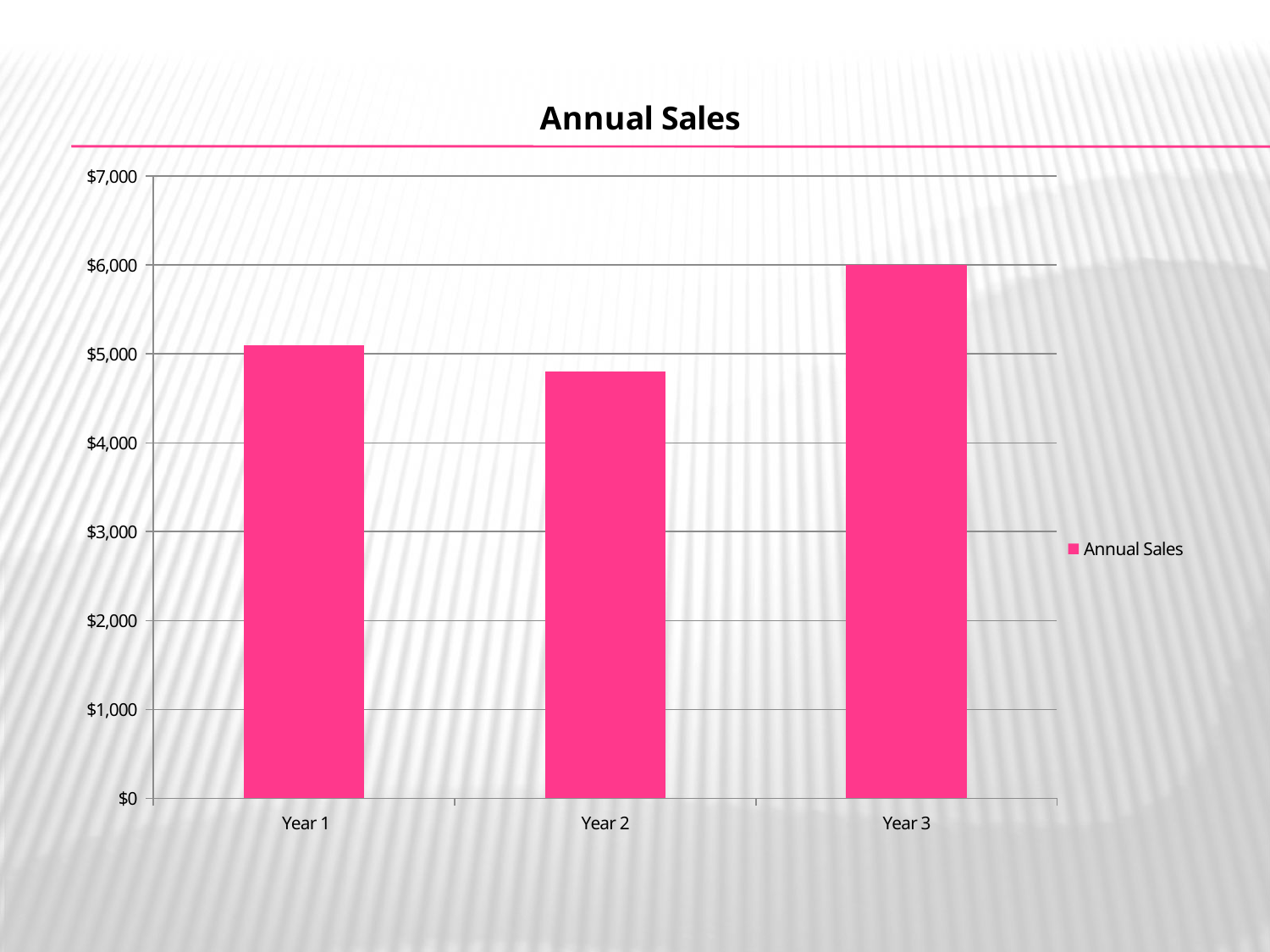
What is the title of the chart? Annual Sales Which is larger, the value for Year 1 or the value for Year 2? Year 1 How many series does the legend list? 1 Is the value for Year 2 greater or less than $5,000? less What colour are the bars in the chart? pink Which year has the highest annual sales? Year 3 Is the value for Year 1 greater or less than $6,000? less How many categories are plotted on the x axis? 3 Does the value rise or fall from Year 2 to Year 3? rise What kind of chart is shown on the slide? bar chart Which year has the lowest annual sales? Year 2 Is the value for Year 1 greater or less than $5,000? greater